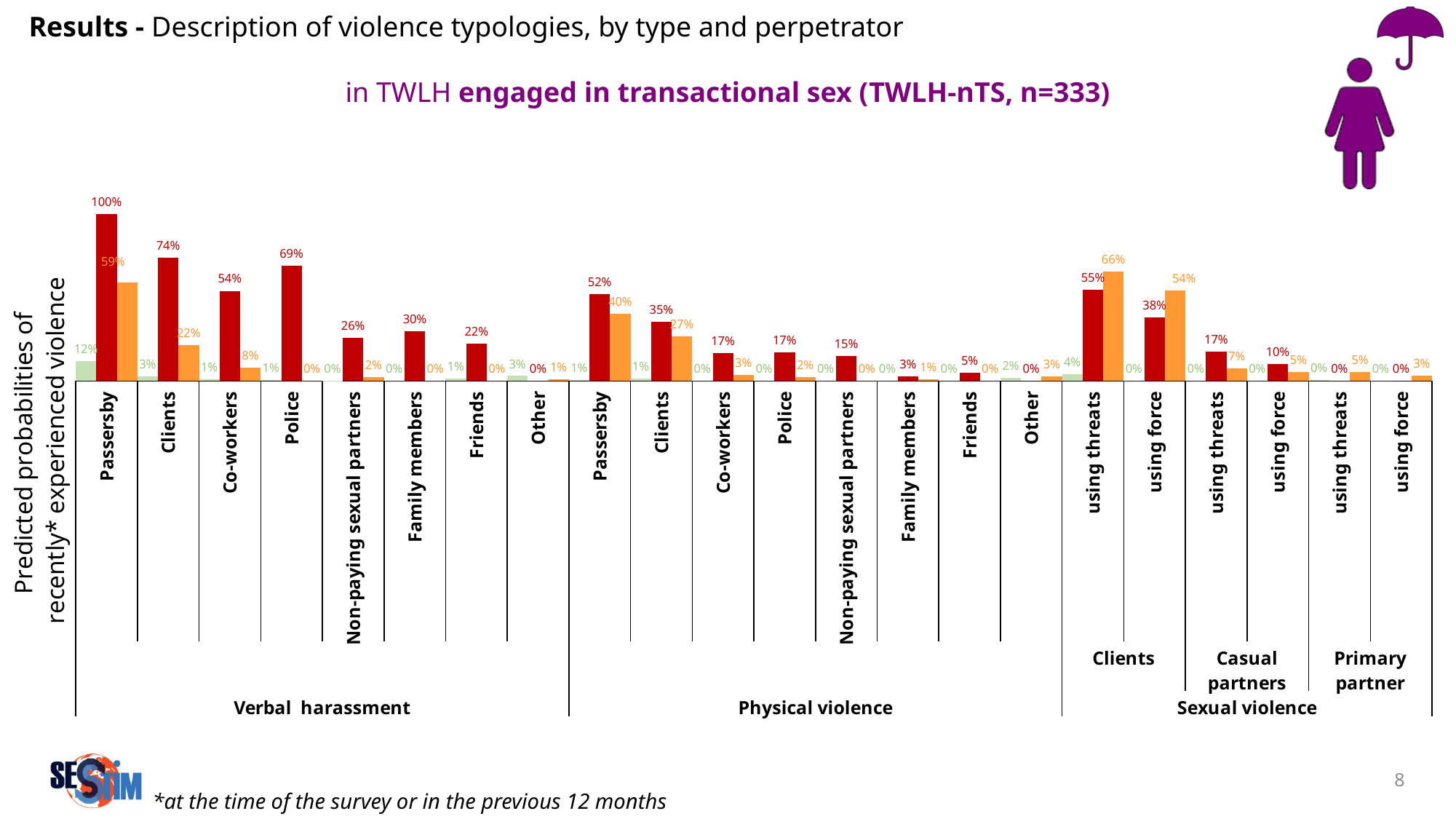
What are the three violence types grouped along the bottom of the chart? Verbal harassment, Physical violence, Sexual violence Under Verbal harassment, which perpetrator category has the highest orange bar? Passersby What is the value of the orange bar for Clients under Verbal harassment? 22% What is the value of the red bar for Police under Physical violence? 17% What is the value of the red bar for Passersby under Verbal harassment? 100% What kind of chart is shown on the slide? bar chart Under Physical violence, which is larger for Passersby: the red bar or the orange bar? the red bar Under Sexual violence, which is larger for Clients using force: the red bar or the orange bar? the orange bar What is the difference between the red bars for Clients (74%) and Police (69%) under Verbal harassment? 5% What is the value of the orange bar for Clients using threats under Sexual violence? 66% How many perpetrator categories are shown along the x axis in total? 22 Which category has the highest red bar in the chart? Passersby (Verbal harassment)